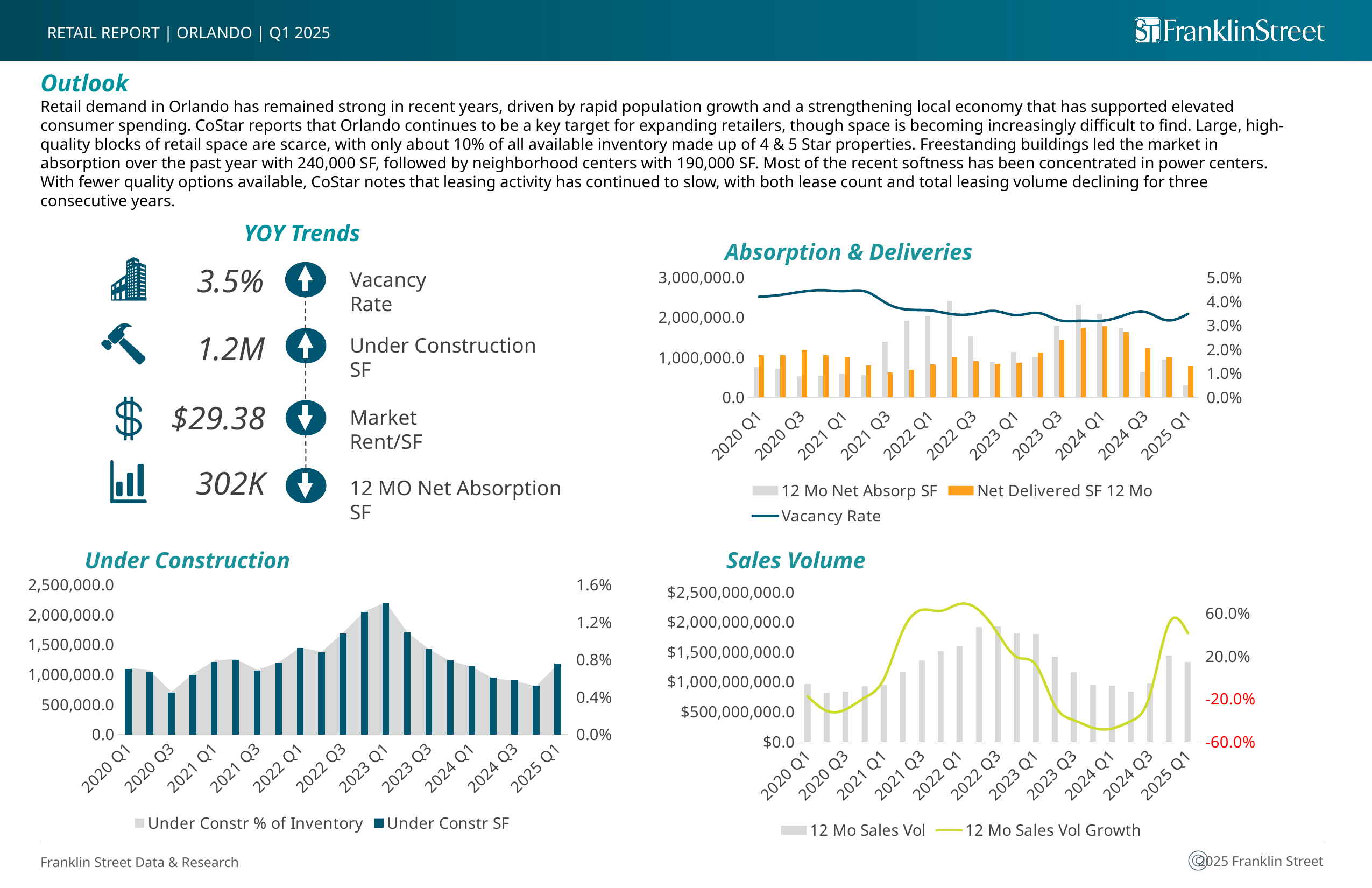
In the Sales Volume chart, is the 12 Mo Sales Vol Growth for 2025 Q1 greater or less than 20.0%? greater In the Under Construction chart, is the Under Constr SF for 2020 Q3 greater or less than 1,000,000.0? less In the Under Construction chart, how many series does the legend list? 2 In the Sales Volume chart, is the 12 Mo Sales Vol for 2022 Q3 greater or less than $1,500,000,000.0? greater In the Under Construction chart, which is larger, the Under Constr SF for 2023 Q1 or for 2025 Q1? 2023 Q1 What is the title of the chart in the top right of the slide? Absorption & Deliveries In the Absorption & Deliveries chart, how many series does the legend list? 3 In the Absorption & Deliveries chart, which quarter has the lowest 12 Mo Net Absorp SF? 2025 Q1 In the Under Construction chart, which quarter has the highest Under Constr SF? 2023 Q1